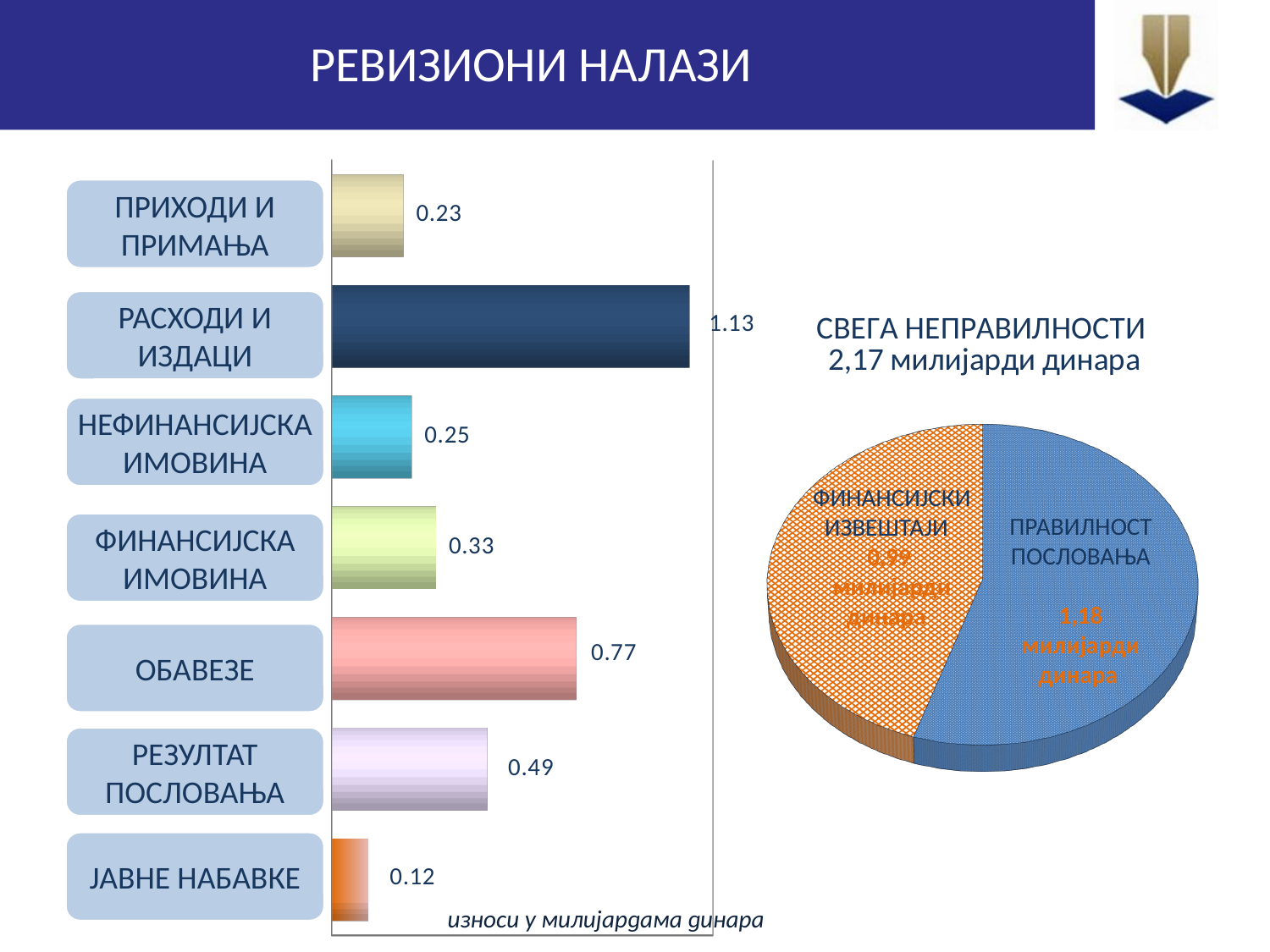
How many categories are shown in the bar chart on the left? 7 In the bar chart on the left, which category has the highest value? РАСХОДИ И ИЗДАЦИ In the bar chart on the left, which category has the lowest value? ЈАВНЕ НАБАВКЕ In the bar chart on the left, what is the value for ОБАВЕЗЕ? 0.77 In the bar chart on the left, which is larger: ФИНАНСИЈСКА ИМОВИНА or НЕФИНАНСИЈСКА ИМОВИНА? ФИНАНСИЈСКА ИМОВИНА In the bar chart on the left, what is the value for ЈАВНЕ НАБАВКЕ? 0.12 What kind of chart is on the left side of the slide? Bar chart In the bar chart on the left, what is the difference between the values for ОБАВЕЗЕ and РЕЗУЛТАТ ПОСЛОВАЊА? 0.28 In the pie chart on the right, which slice is larger: ФИНАНСИЈСКИ ИЗВЕШТАЈИ or ПРАВИЛНОСТ ПОСЛОВАЊА? ПРАВИЛНОСТ ПОСЛОВАЊА In the bar chart on the left, what is the value for РАСХОДИ И ИЗДАЦИ? 1.13 In the pie chart on the right, what is the value for ПРАВИЛНОСТ ПОСЛОВАЊА? 1,18 милијарди динара What total amount of irregularities is stated above the pie chart on the right? 2,17 милијарди динара